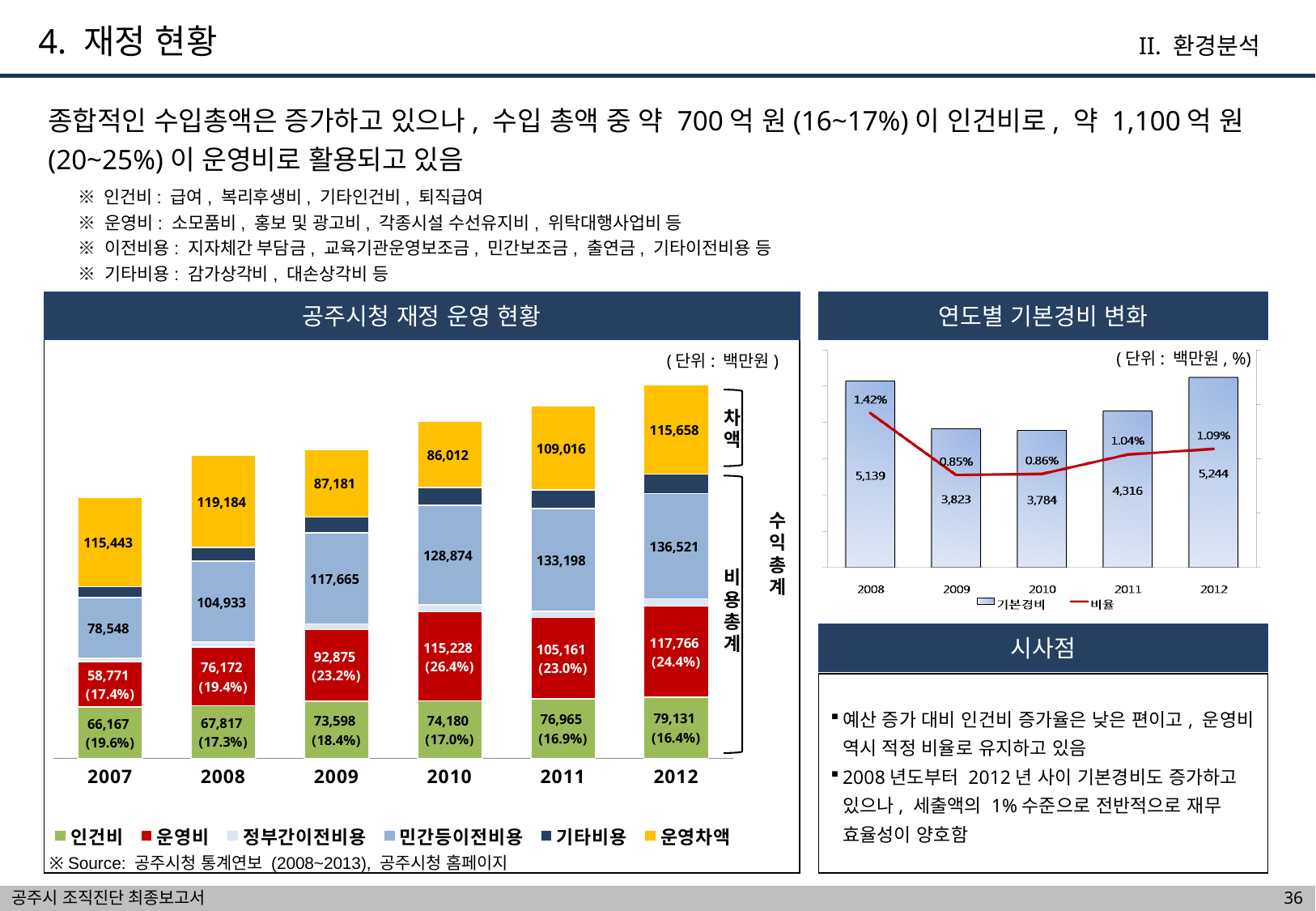
In the 공주시청 재정 운영 현황 chart, what is the 운영차액 value for 2009? 87,181 In the 공주시청 재정 운영 현황 chart, which year has the highest 민간등이전비용 value? 2012 In the 공주시청 재정 운영 현황 chart, does the 인건비 value rise or fall from 2007 to 2012? rise In the 공주시청 재정 운영 현황 chart, what is the 인건비 value for 2012? 79,131 In the 공주시청 재정 운영 현황 chart, what is the difference between the 인건비 values for 2012 and 2007? 12,964 In the 연도별 기본경비 변화 chart, what is the 기본경비 value for 2011? 4,316 In the 공주시청 재정 운영 현황 chart, which year has the larger 운영비 value, 2010 or 2011? 2010 In the 공주시청 재정 운영 현황 chart, what percentage is shown next to the 운영비 value for 2010? 26.4% In the 공주시청 재정 운영 현황 chart, which year has the lowest 운영비 value? 2007 In the 공주시청 재정 운영 현황 chart, how many series does the legend list? 6 In the 연도별 기본경비 변화 chart, which year has the lowest 기본경비 value? 2010 In the 공주시청 재정 운영 현황 chart, how many years are shown on the x axis? 6